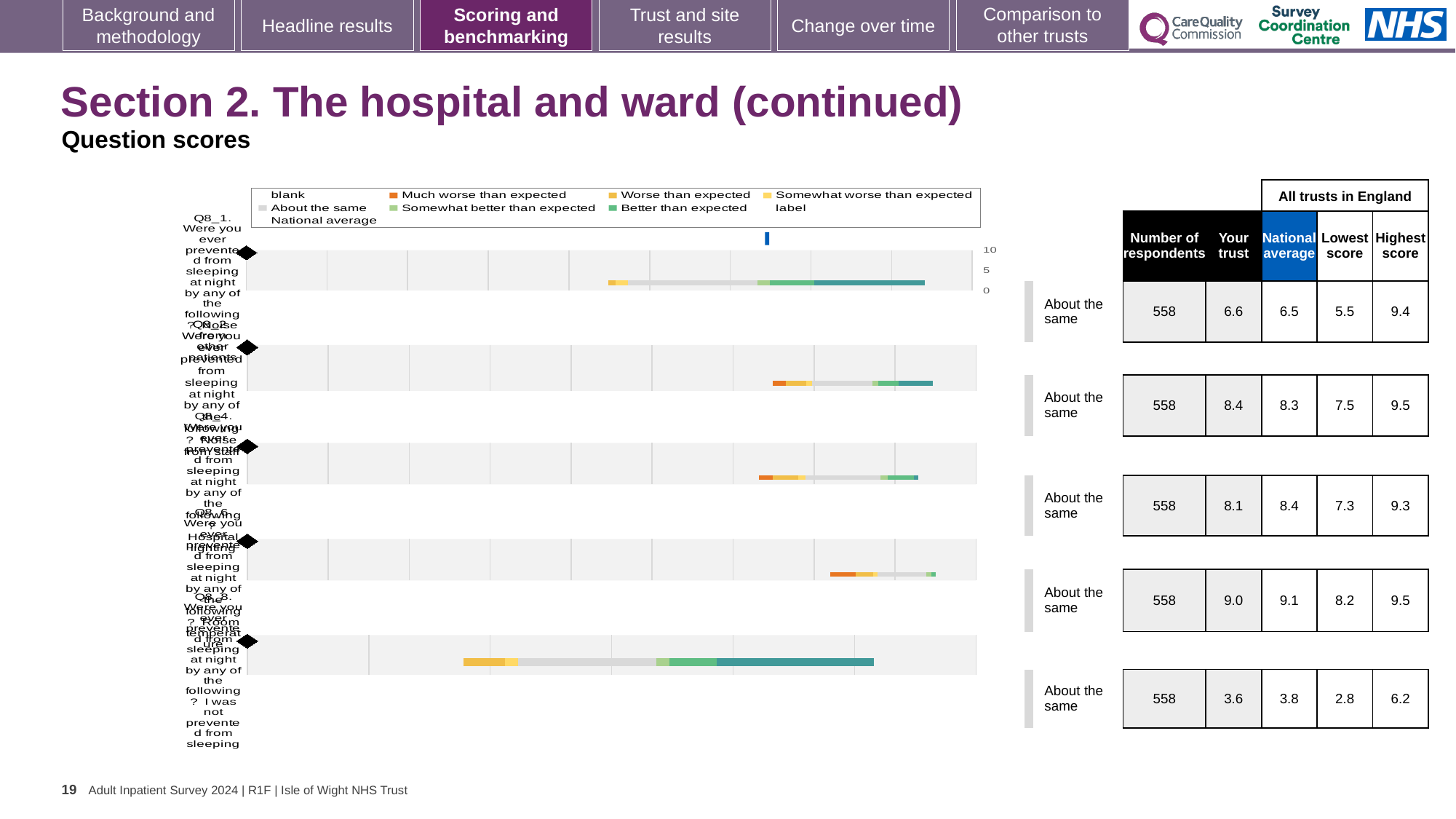
What is the 'Your trust' score for the first row (Q8_1) in the chart? 6.6 Which row has the lowest 'Your trust' score? the fifth row (Q8_8), 3.6 What kind of chart is used to show the question scores on this slide? bar chart For the second row (Q8_2), how much higher is the 'Your trust' score than the 'National average' score? 0.1 For the third row (Q8_4), which is larger: the 'Your trust' score or the 'National average' score? National average For the first row (Q8_1), what is the difference between the highest score and the lowest score across all trusts in England? 3.9 Which row has the highest 'Your trust' score? the fourth row (Q8_6), 9.0 What is the 'National average' score for the last row (Q8_8) in the chart? 3.8 How many respondents are listed for each question row in the chart? 558 What is the 'Lowest score' for the fifth row (Q8_8)? 2.8 What benchmark category label is shown next to every row of the chart? About the same How many question rows (bars) are plotted in the chart? 5